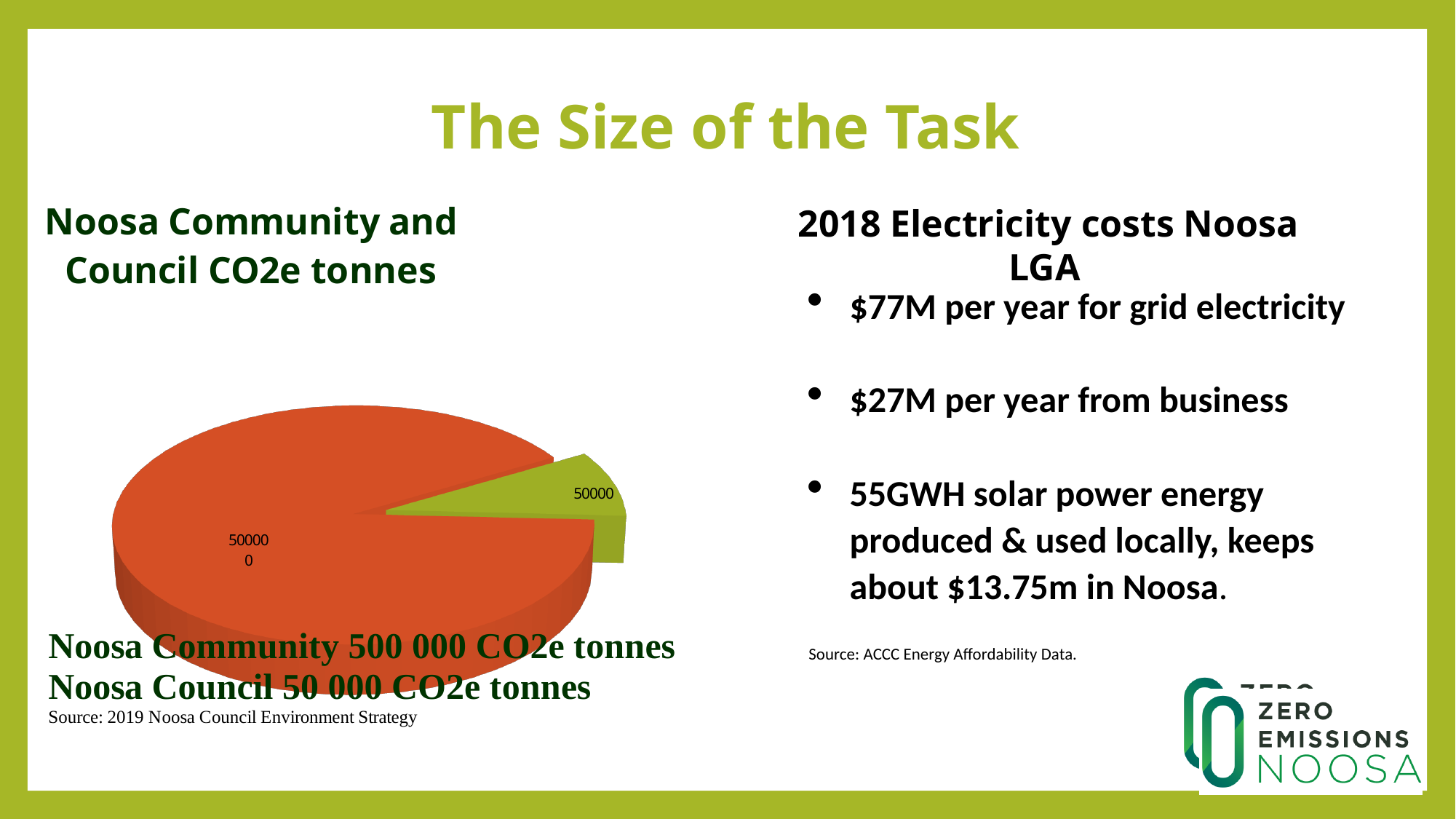
What value is labelled on the small green slice of the pie chart? 50000 What is the difference in CO2e tonnes between the Noosa Community slice and the Noosa Council slice? 450000 What is the title of the pie chart? Noosa Community and Council CO2e tonnes What is the total of the two slices in the pie chart, in CO2e tonnes? 550000 Which category has the smallest slice in the pie chart? Noosa Council What value is labelled on the large orange slice of the pie chart? 500000 Which category has the largest slice in the pie chart? Noosa Community Which has the larger slice in the pie chart, Noosa Community or Noosa Council? Noosa Community What colour is the larger slice of the pie chart? orange What kind of chart is shown on the slide? pie chart How many slices does the pie chart have? 2 What share of the pie does the Noosa Council slice represent? 9.1%